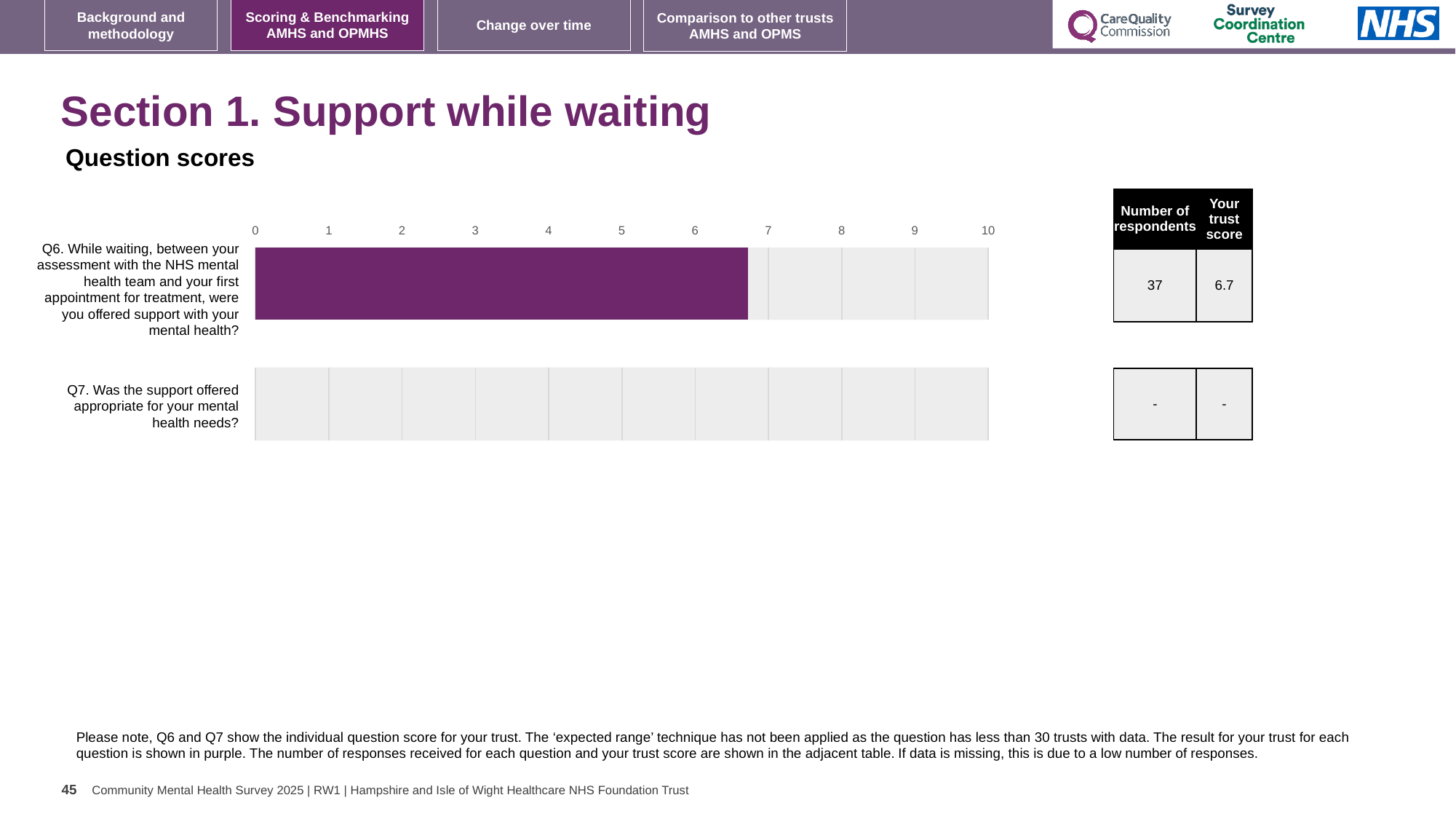
How many questions (categories) are listed on the chart? 2 What is the trust score for Q6 shown in the table next to the chart? 6.7 Is the value of the bar for Q6 greater or less than 6? greater What is the trust score shown in the table for Q7? - Which question on the chart has no bar plotted (missing data)? Q7 What is the highest value shown on the chart's axis? 10 Is the value of the bar for Q6 greater or less than 7? less How many respondents answered Q6 according to the table beside the chart? 37 What colour is the bar for Q6? purple What kind of chart is shown on the slide? bar chart